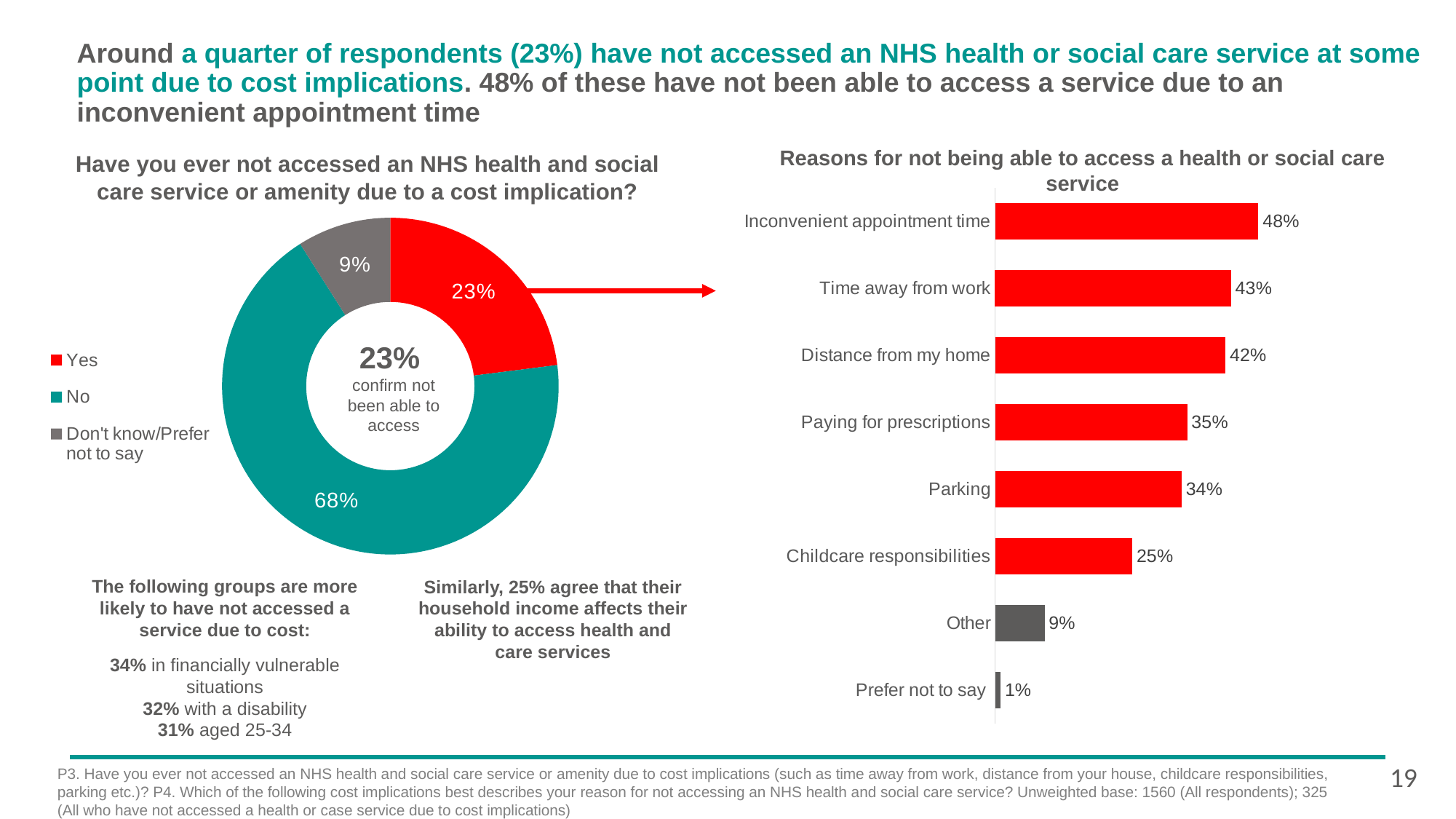
How many categories are shown in the bar chart 'Reasons for not being able to access a health or social care service'? 8 In the donut chart on the left, what percentage answered No? 68% In the bar chart 'Reasons for not being able to access a health or social care service', what is the value for Time away from work? 43% In the bar chart on the right, which category has the lowest value? Prefer not to say In the bar chart on the right, which reason has the highest value? Inconvenient appointment time In the donut chart on the left, which response has the largest share? No In the donut chart 'Have you ever not accessed an NHS health and social care service or amenity due to a cost implication?', what percentage answered Yes? 23% In the bar chart 'Reasons for not being able to access a health or social care service', what is the value for Parking? 34% In the bar chart on the right, which is larger: Paying for prescriptions or Childcare responsibilities? Paying for prescriptions How many entries does the legend of the donut chart on the left list? 3 In the bar chart on the right, what is the difference between Inconvenient appointment time and Childcare responsibilities? 23% In the donut chart on the left, what share is 'Don't know/Prefer not to say'? 9%